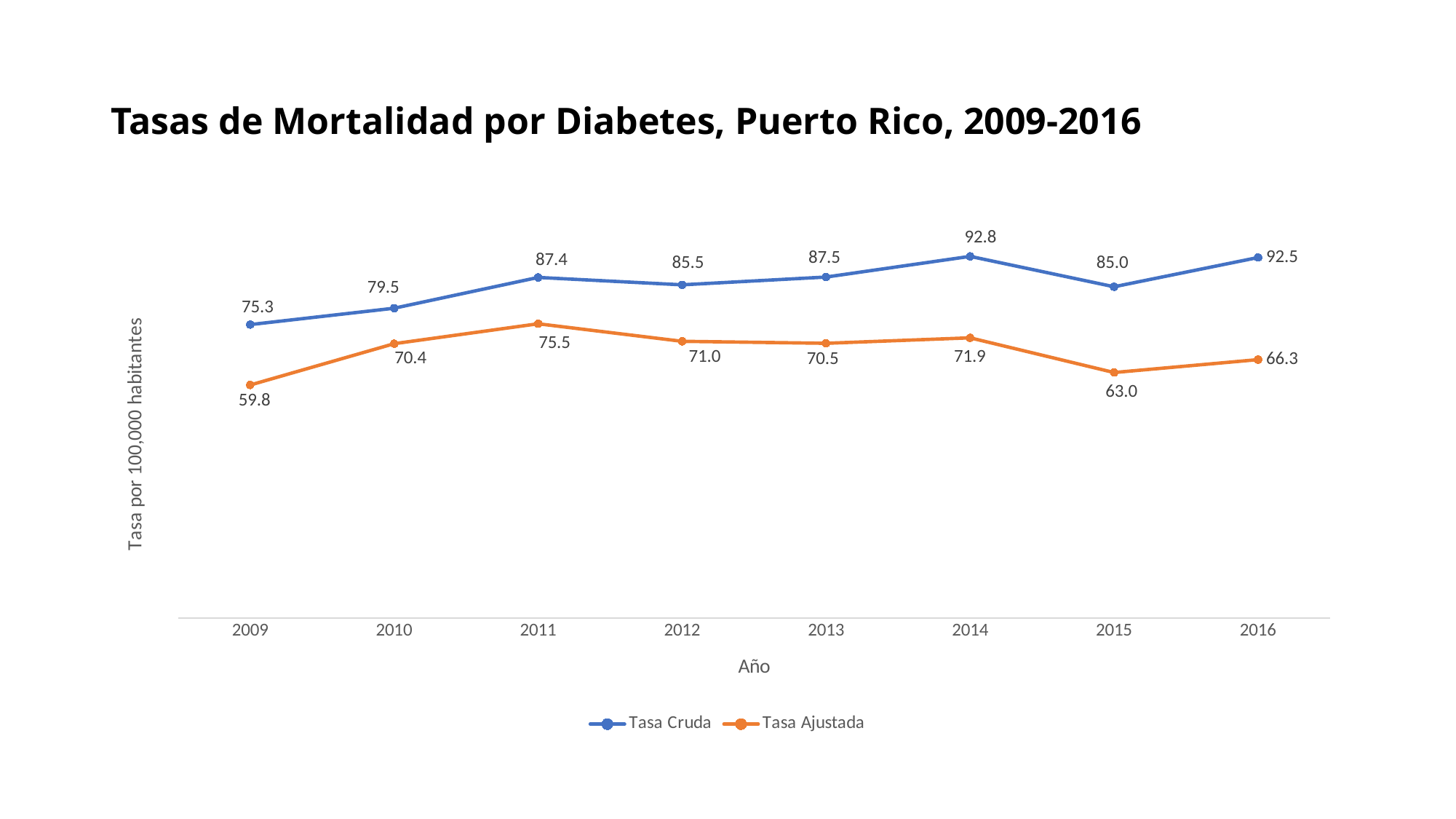
Which is larger, the Tasa Ajustada in 2011 or the Tasa Ajustada in 2014? Tasa Ajustada in 2011 What is the Tasa Ajustada value for 2015? 63.0 What is the Tasa Ajustada value for 2009? 59.8 What is the title of the chart? Tasas de Mortalidad por Diabetes, Puerto Rico, 2009-2016 How many years are shown on the x axis? 8 What is the Tasa Cruda value for 2014? 92.8 How many series does the legend list? 2 Does the Tasa Cruda rise or fall from 2009 to 2011? Rise In which year is the Tasa Ajustada lowest? 2009 What kind of chart is shown on the slide? Line chart In which year is the Tasa Cruda highest? 2014 What is the difference between the Tasa Cruda and the Tasa Ajustada in 2016? 26.2